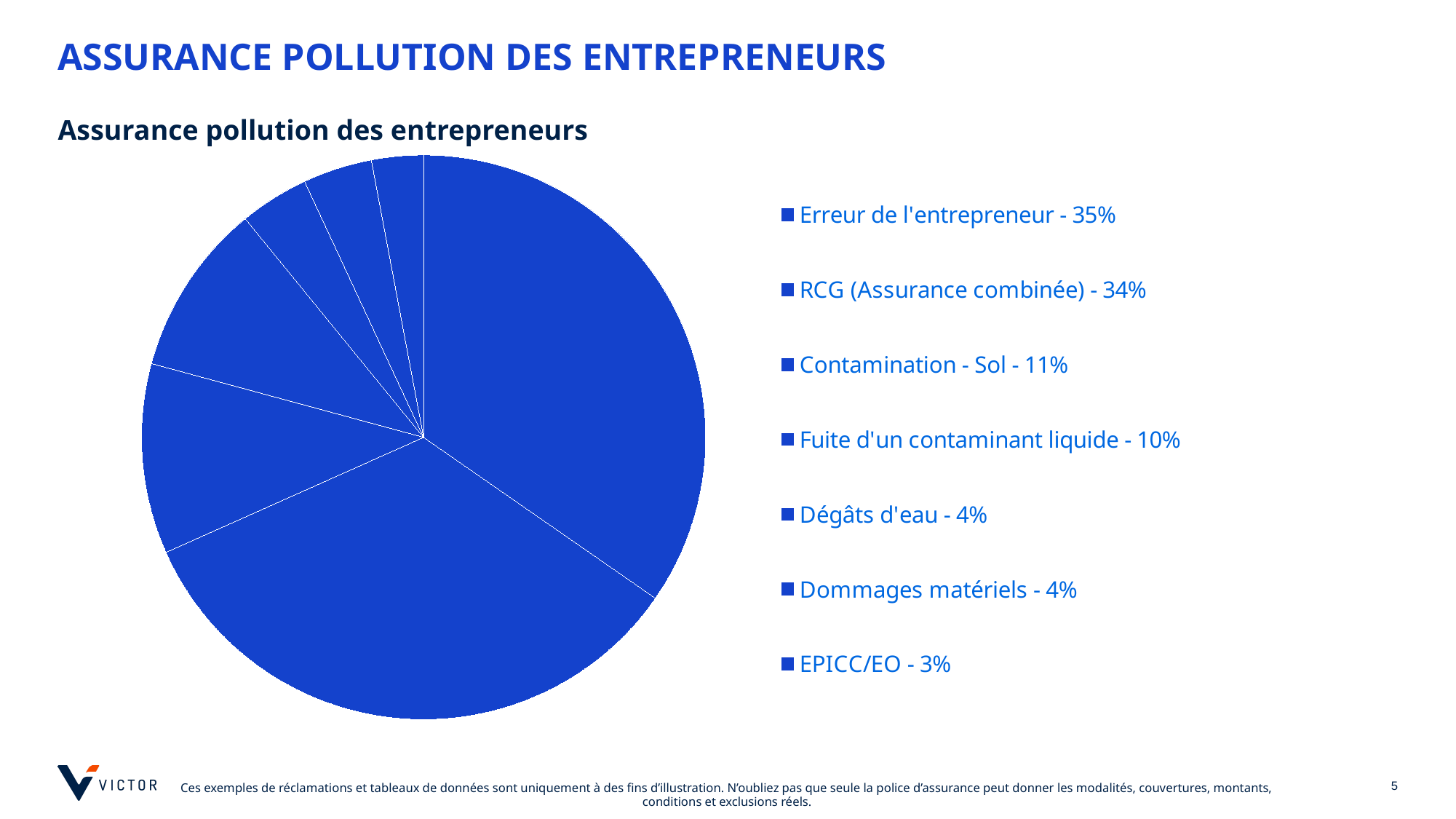
How many categories does the legend of the pie chart list? 7 What percentage is shown for "RCG (Assurance combinée)"? 34% What is the title of the pie chart? Assurance pollution des entrepreneurs What percentage is shown for "EPICC/EO"? 3% What percentage is shown for "Contamination - Sol"? 11% Which category has the largest share of the pie? Erreur de l'entrepreneur What percentage is shown for "Fuite d'un contaminant liquide"? 10% Which category has the smallest share of the pie? EPICC/EO What kind of chart is shown on the slide? pie chart What share of the pie does "Erreur de l'entrepreneur" represent? 35% Which is larger: the share for "Contamination - Sol" or the share for "Fuite d'un contaminant liquide"? Contamination - Sol What is the difference in percentage points between "Erreur de l'entrepreneur" and "Contamination - Sol"? 24